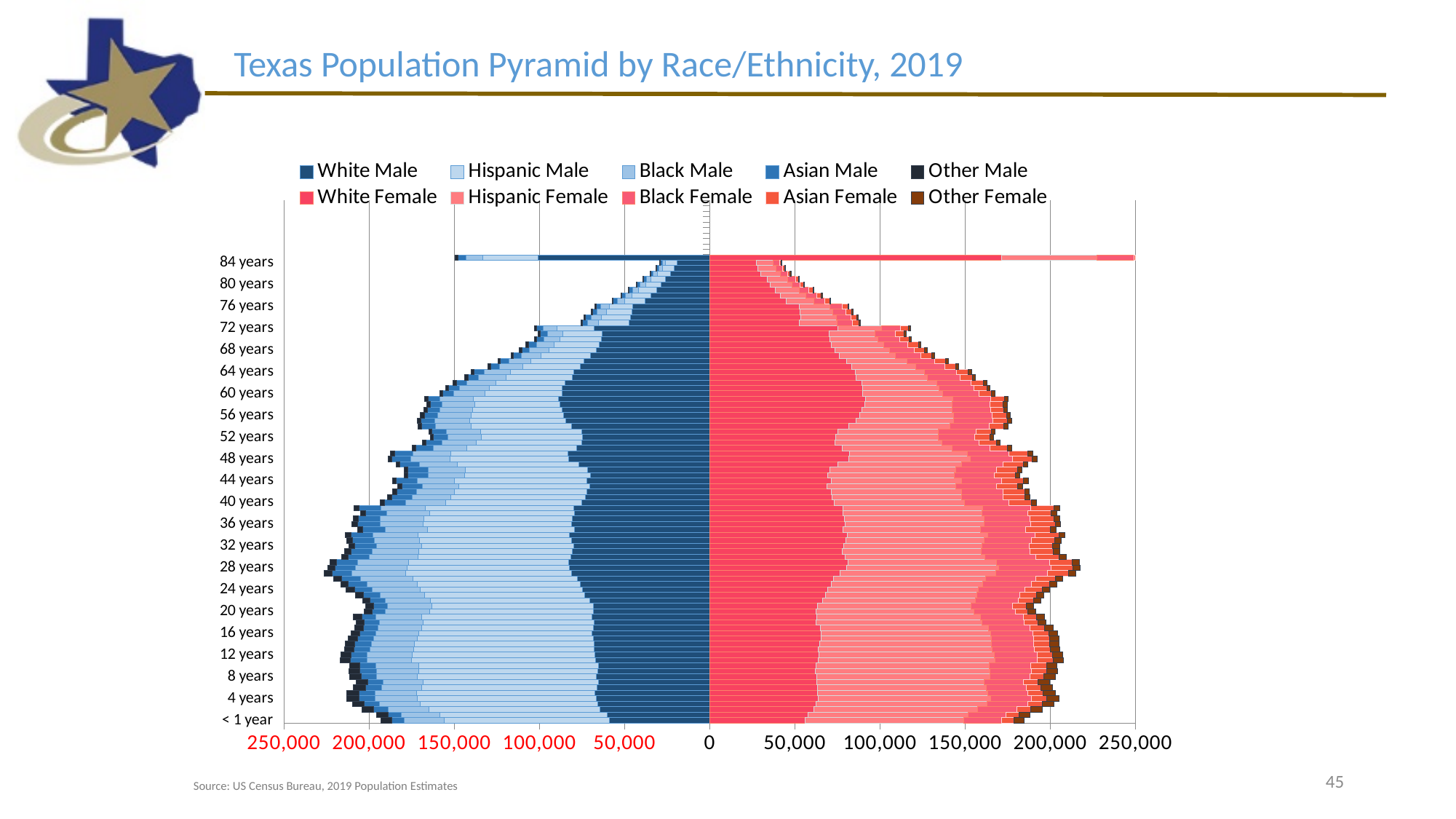
What type of chart is shown on the slide? Bar chart (stacked population pyramid) Is the total female value for 60 years greater or less than 150,000? greater How many age labels are shown on the vertical axis? 22 Is the total male value for 28 years greater or less than 200,000? greater Is the total male value for 60 years greater or less than 150,000? greater What is the title of the chart on the slide? Texas Population Pyramid by Race/Ethnicity, 2019 How many series does the legend list? 10